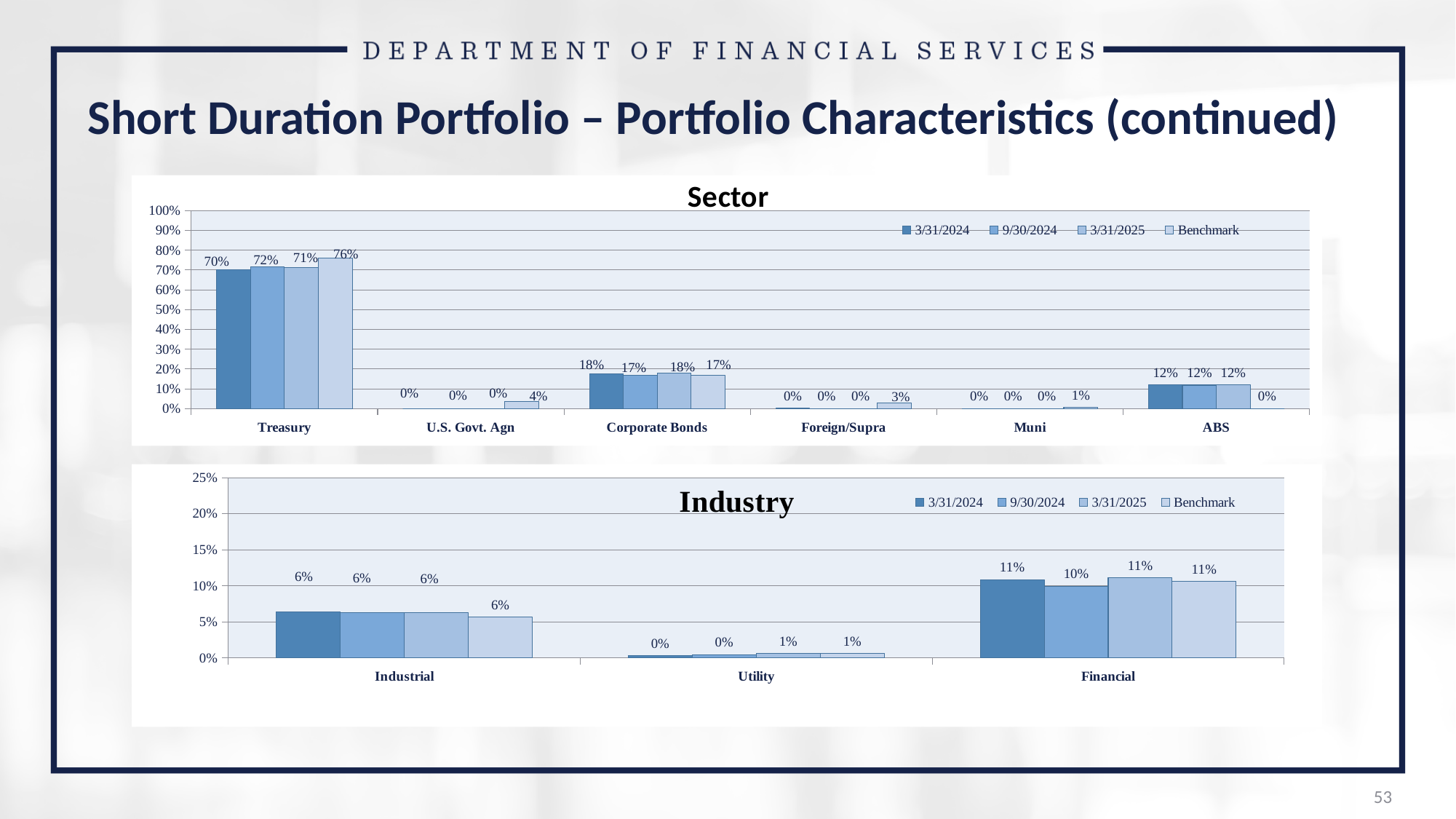
In the Sector chart, what is the 3/31/2025 value for Corporate Bonds? 18% In the Sector chart, what is the Benchmark value for Treasury? 76% In the Sector chart, which category has the highest 3/31/2024 value? Treasury In the Industry chart, what is the 9/30/2024 value for Financial? 10% What kind of chart is the Industry chart? Bar chart In the Industry chart, which category has the lowest Benchmark value? Utility In the Sector chart, how many series does the legend list? 4 In the Sector chart, what is the difference between the Benchmark and 3/31/2024 values for Treasury? 6% In the Industry chart, what is the 3/31/2025 value for Utility? 1% In the Sector chart, what is the Benchmark value for U.S. Govt. Agn? 4% In the Industry chart, which is larger: the 3/31/2024 value for Industrial or the 3/31/2024 value for Financial? Financial In the Sector chart, how many categories are shown on the x axis? 6